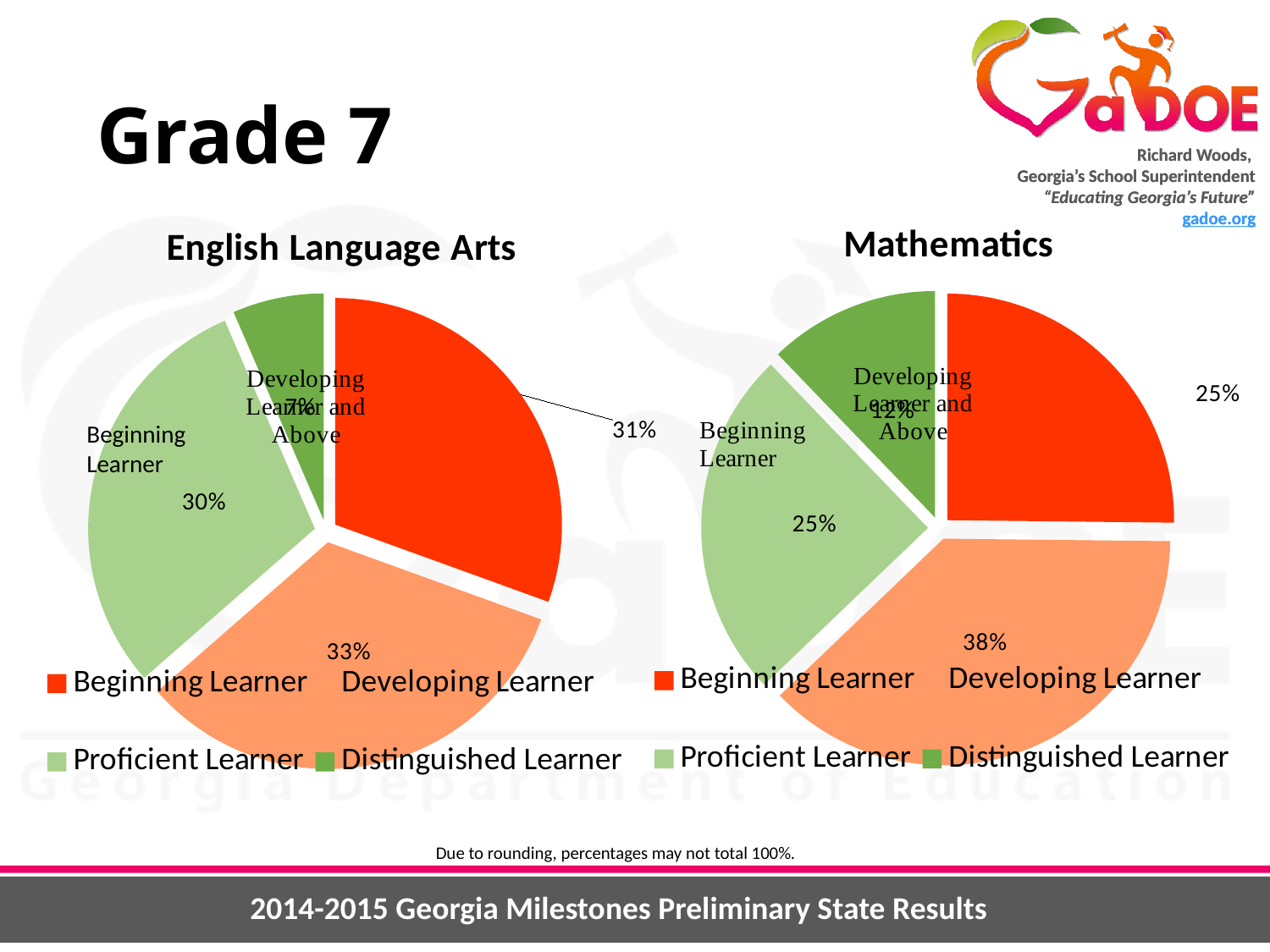
In the English Language Arts pie chart, which category has the smallest slice? Distinguished Learner How many entries does the legend of the English Language Arts chart list? 4 In the Mathematics pie chart, what percentage is shown for Developing Learner? 38% In the English Language Arts pie chart, what percentage is shown for Distinguished Learner? 7% Which chart shows a larger percentage for Distinguished Learner, English Language Arts or Mathematics? Mathematics How many slices does the Mathematics pie chart have? 4 In the Mathematics pie chart, what percentage is shown for Distinguished Learner? 12% In the Mathematics pie chart, what is the difference in percentage points between Developing Learner and Distinguished Learner? 26 In the English Language Arts pie chart, what is the difference in percentage points between Developing Learner and Distinguished Learner? 26 What type of chart is used for English Language Arts? Pie chart In the English Language Arts pie chart, what percentage is shown for Developing Learner? 33% In the Mathematics pie chart, which category has the largest slice? Developing Learner